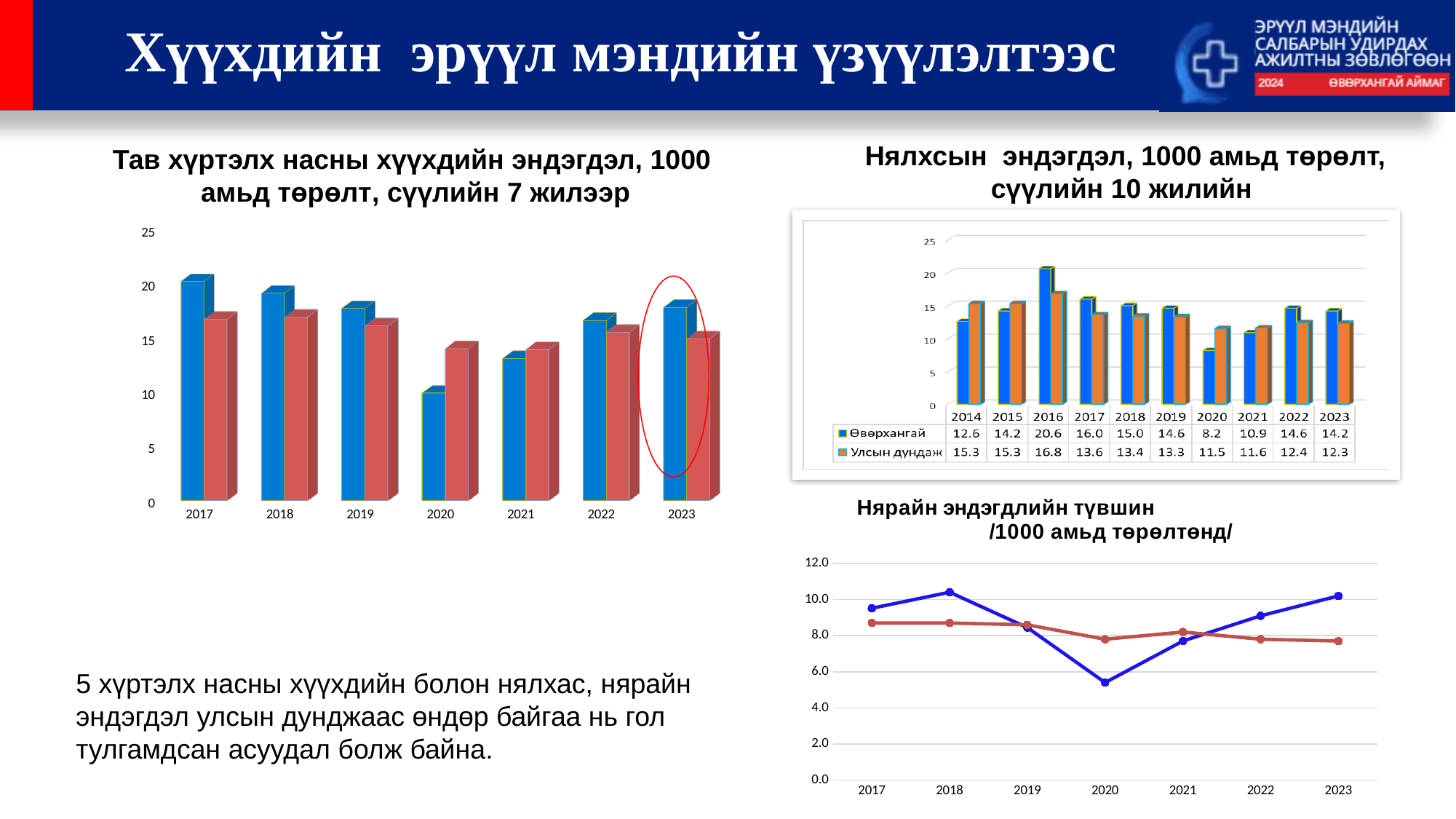
In the chart titled 'Нялхсын эндэгдэл, 1000 амьд төрөлт, сүүлийн 10 жилийн', what is the difference between the Өвөрхангай and Улсын дундаж values in 2016? 3.8 In the chart titled 'Нялхсын эндэгдэл, 1000 амьд төрөлт, сүүлийн 10 жилийн', which series has the larger value in 2023, Өвөрхангай or Улсын дундаж? Өвөрхангай In the chart titled 'Нялхсын эндэгдэл, 1000 амьд төрөлт, сүүлийн 10 жилийн', in which year is the Өвөрхангай value highest? 2016 In the chart titled 'Нялхсын эндэгдэл, 1000 амьд төрөлт, сүүлийн 10 жилийн', in which year is the Өвөрхангай value lowest? 2020 In the chart titled 'Тав хүртэлх насны хүүхдийн эндэгдэл, 1000 амьд төрөлт, сүүлийн 7 жилээр', is the value of the blue bar for 2020 greater or less than 15? less In the chart titled 'Нялхсын эндэгдэл, 1000 амьд төрөлт, сүүлийн 10 жилийн', what is the value for Улсын дундаж in 2020? 11.5 In the chart titled 'Нярайн эндэгдлийн түвшин /1000 амьд төрөлтөнд/', is the value of the blue line for 2020 greater or less than 6.0? less In the chart titled 'Нялхсын эндэгдэл, 1000 амьд төрөлт, сүүлийн 10 жилийн', what is the value for Өвөрхангай in 2016? 20.6 In the chart titled 'Нялхсын эндэгдэл, 1000 амьд төрөлт, сүүлийн 10 жилийн', how many series does the legend list? 2 What kind of chart is the one titled 'Тав хүртэлх насны хүүхдийн эндэгдэл, 1000 амьд төрөлт, сүүлийн 7 жилээр'? Bar chart In the chart titled 'Нялхсын эндэгдэл, 1000 амьд төрөлт, сүүлийн 10 жилийн', how many years are shown on the x axis? 10 What kind of chart is the one titled 'Нярайн эндэгдлийн түвшин /1000 амьд төрөлтөнд/'? Line chart